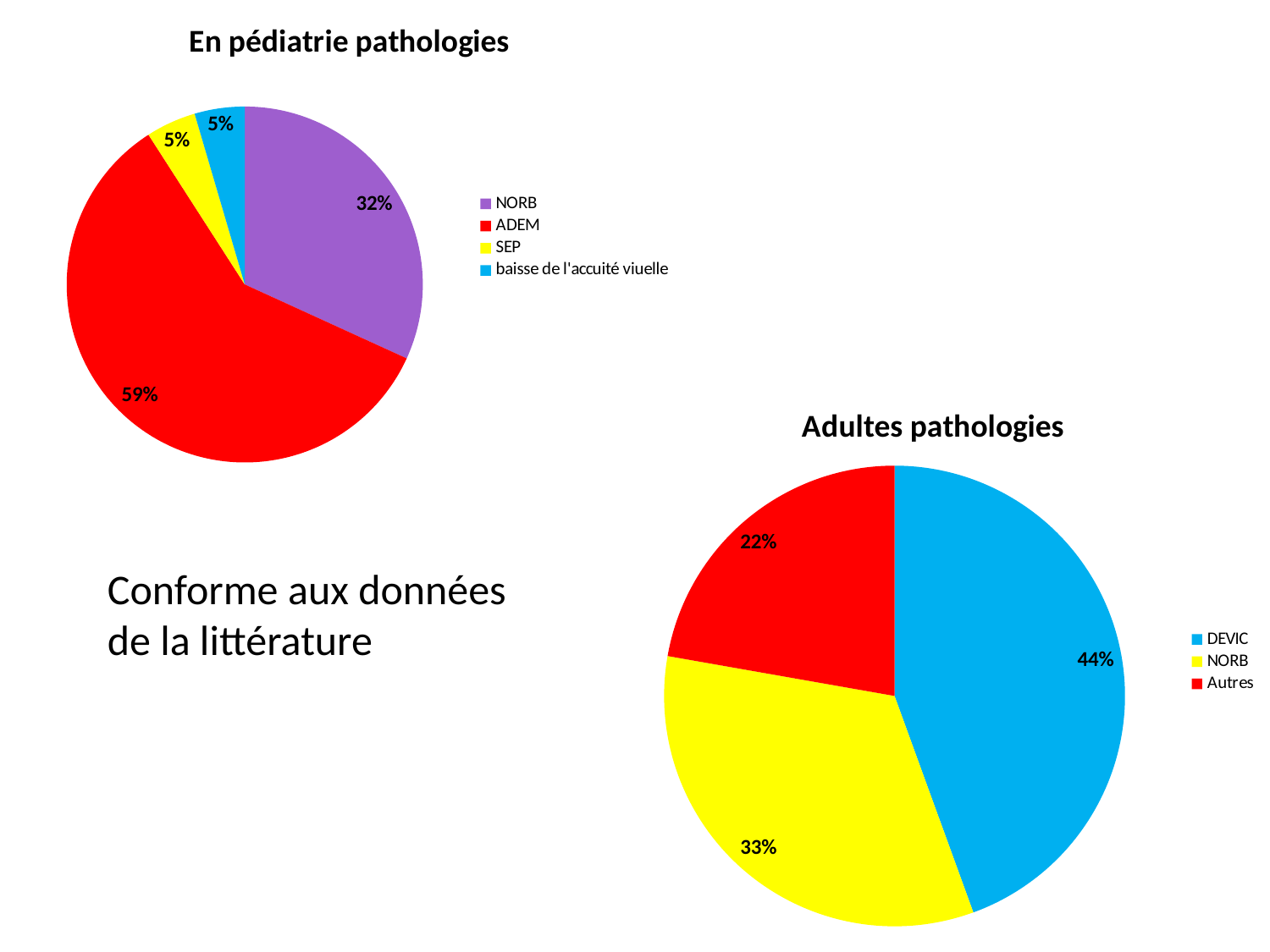
In the 'En pédiatrie pathologies' chart, what is the difference between the ADEM share and the NORB share? 27% In the 'En pédiatrie pathologies' chart, what share does ADEM have? 59% In the 'En pédiatrie pathologies' chart, what share does NORB have? 32% What kind of chart is the 'Adultes pathologies' chart? Pie chart In the 'Adultes pathologies' chart, which category has the smallest share? Autres In the 'Adultes pathologies' chart, what share does DEVIC have? 44% In the 'Adultes pathologies' chart, which is larger, NORB or Autres? NORB In the 'En pédiatrie pathologies' chart, how many categories does the legend list? 4 In the 'Adultes pathologies' chart, what colour is the DEVIC slice? Blue In the 'En pédiatrie pathologies' chart, which category has the largest share? ADEM